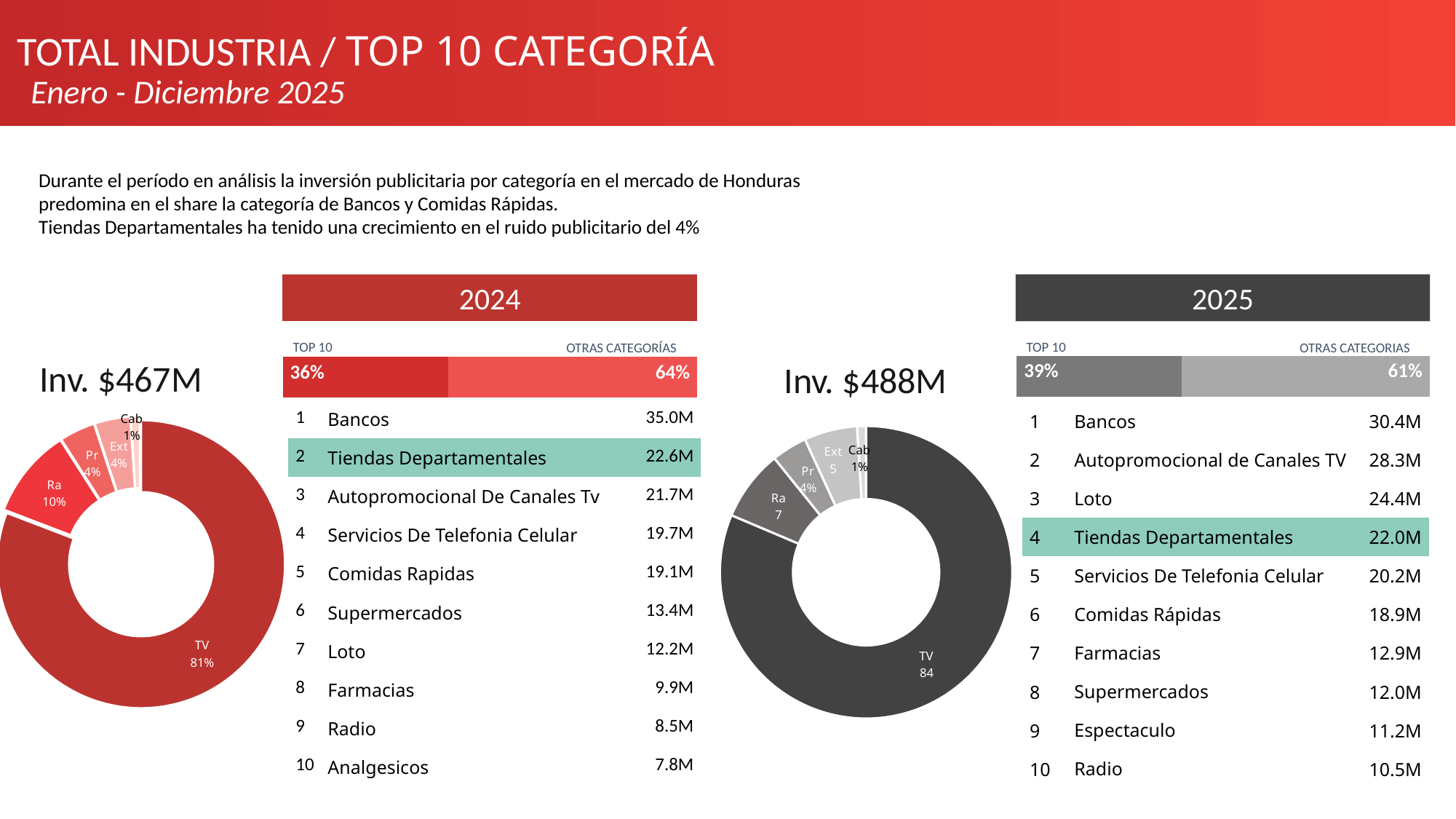
What kind of chart is shown under "Inv. $467M" on the left of the slide? Donut chart In the 2024 donut chart (left), what share does Ra have? 10% In the 2025 donut chart (right), what is the value shown for TV? 84 How many segments does the 2024 donut chart (left) have? 5 In the 2025 donut chart (right), what is the value shown for Ext? 5 In the 2024 donut chart (left), which segment is the largest? TV In the 2025 donut chart (right), what is the value shown for Ra? 7 In the 2024 donut chart (left), which segment is the smallest? Cab In the 2024 donut chart (left), which is larger, Ra or Pr? Ra In the 2024 donut chart (left), what is the difference between the TV share and the Ra share? 71% In the 2024 donut chart (left), what share does TV have? 81% In the 2025 donut chart (right), which segment is the smallest? Cab